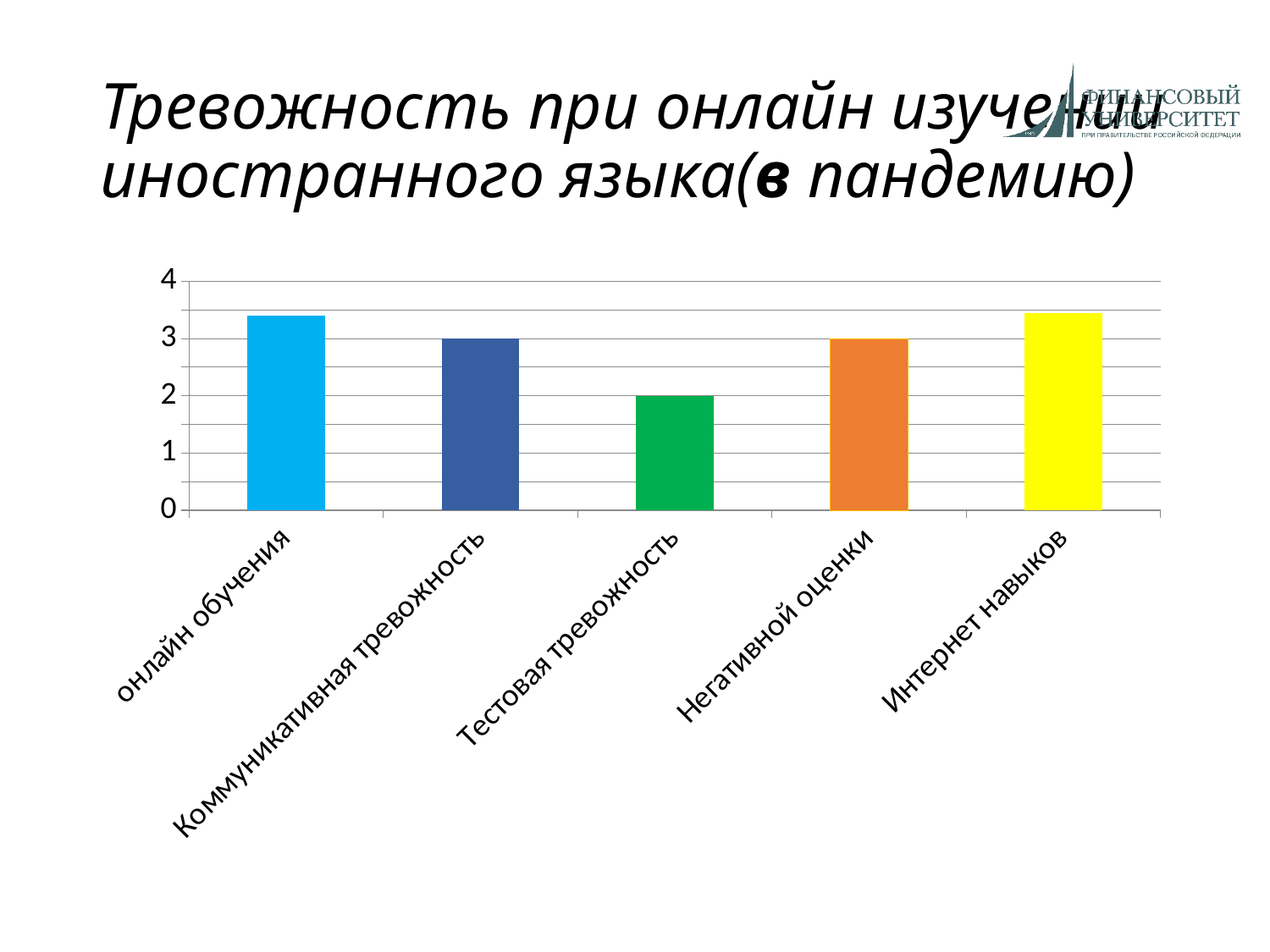
What is the difference between the values for Коммуникативная тревожность and Тестовая тревожность? 1 Is the value for Тестовая тревожность greater or less than 3? less What type of chart is shown on the slide? bar chart Which is larger, the value for онлайн обучения or the value for Тестовая тревожность? онлайн обучения How many categories are shown on the x axis of the chart? 5 What colour is the bar for Тестовая тревожность? green What is the value for Коммуникативная тревожность? 3 What is the value for Негативной оценки? 3 Is the value for Интернет навыков greater or less than 3? greater Which category has the lowest value? Тестовая тревожность Is the value for онлайн обучения greater or less than 3? greater What is the value for Тестовая тревожность? 2